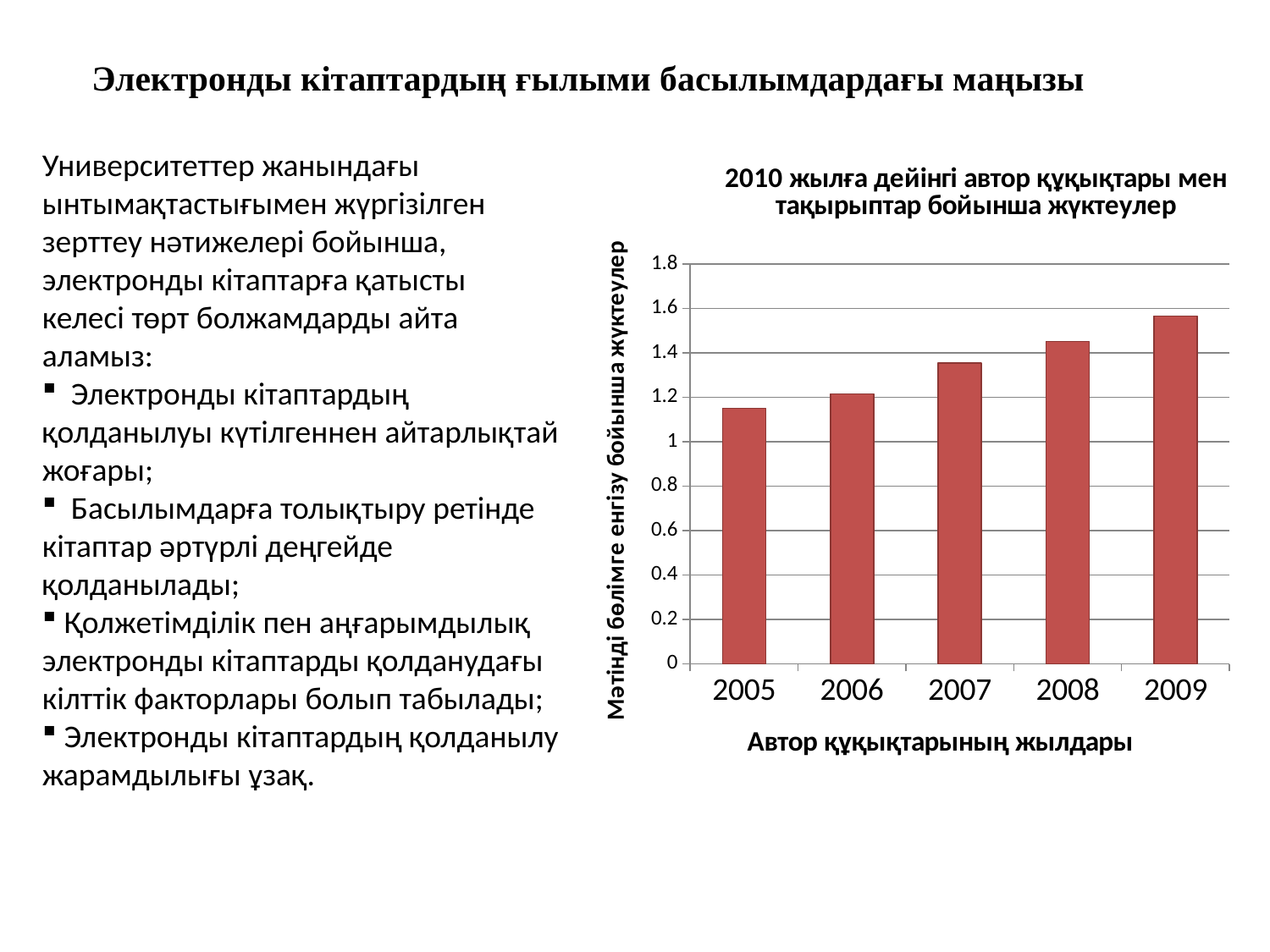
Which is larger, the value for 2007 or the value for 2006? 2007 Is the value for 2009 greater or less than 1.6? less How many years are shown on the x axis of the chart? 5 Is the value for 2005 greater or less than 1? greater Is the value for 2006 greater or less than 1.4? less Which year has the lowest bar in the chart? 2005 Do the values rise or fall from 2005 to 2009? rise What is the label of the x axis of the chart? Автор құқықтарының жылдары Which year has the highest bar in the chart? 2009 What is the title of the chart? 2010 жылға дейінгі автор құқықтары мен тақырыптар бойынша жүктеулер What kind of chart is shown on the slide? bar chart